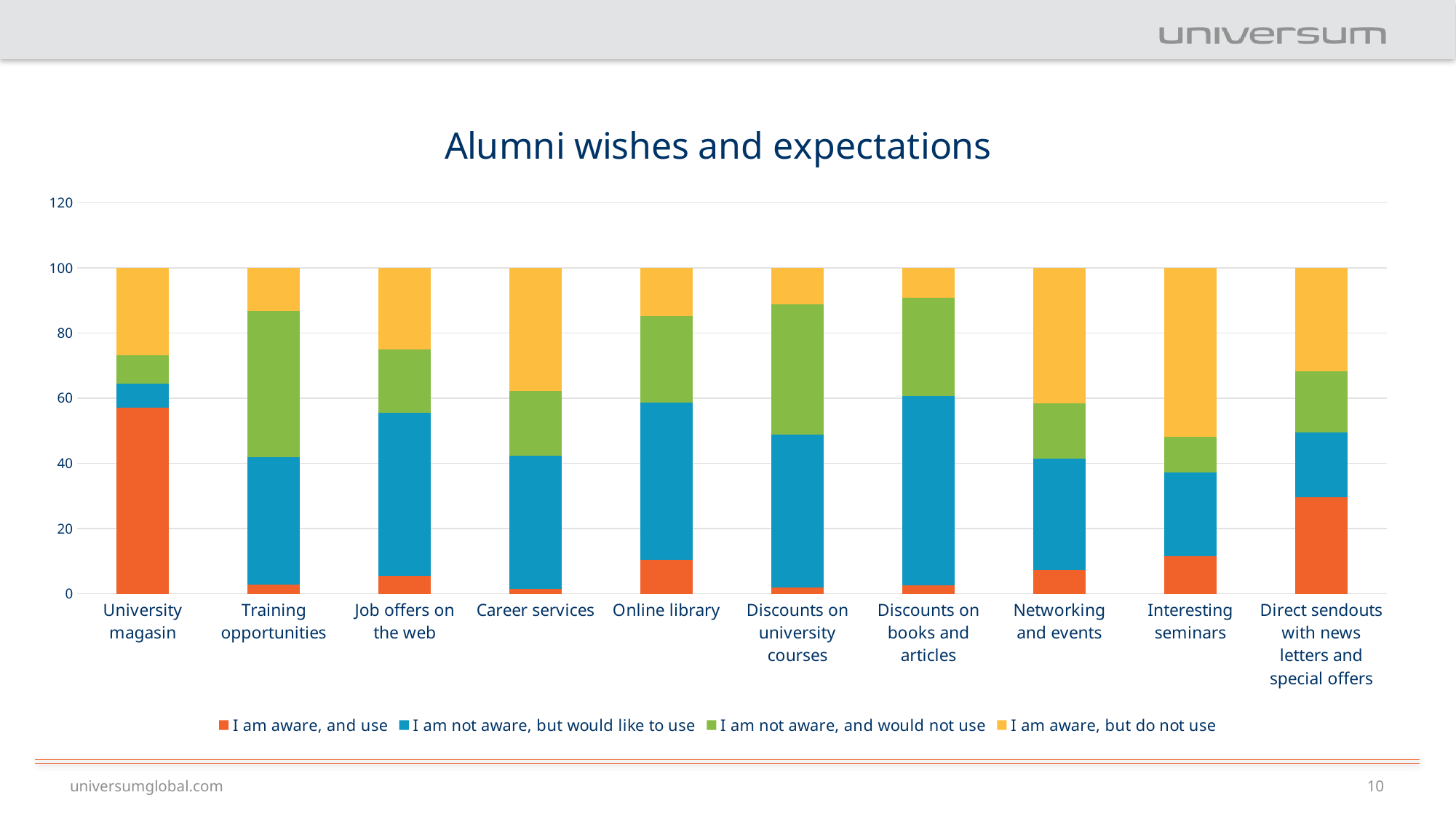
How many categories are shown along the x axis of the chart? 10 Which category has the largest 'I am aware, but do not use' segment? Interesting seminars What is the total height of the stacked bar for University magasin? 100 Which has a larger 'I am aware, and use' segment: University magasin or Direct sendouts with news letters and special offers? University magasin Which has a larger 'I am not aware, but would like to use' segment: Discounts on books and articles or Training opportunities? Discounts on books and articles How many series does the legend list? 4 Which colour represents the series 'I am aware, but do not use' in the legend? Yellow What is the title of the chart? Alumni wishes and expectations What kind of chart is shown on the slide? Stacked bar chart Is the 'I am aware, and use' value for Online library greater or less than 20? less Which category has the largest 'I am aware, and use' segment? University magasin Is the 'I am aware, and use' value for University magasin greater or less than 40? greater